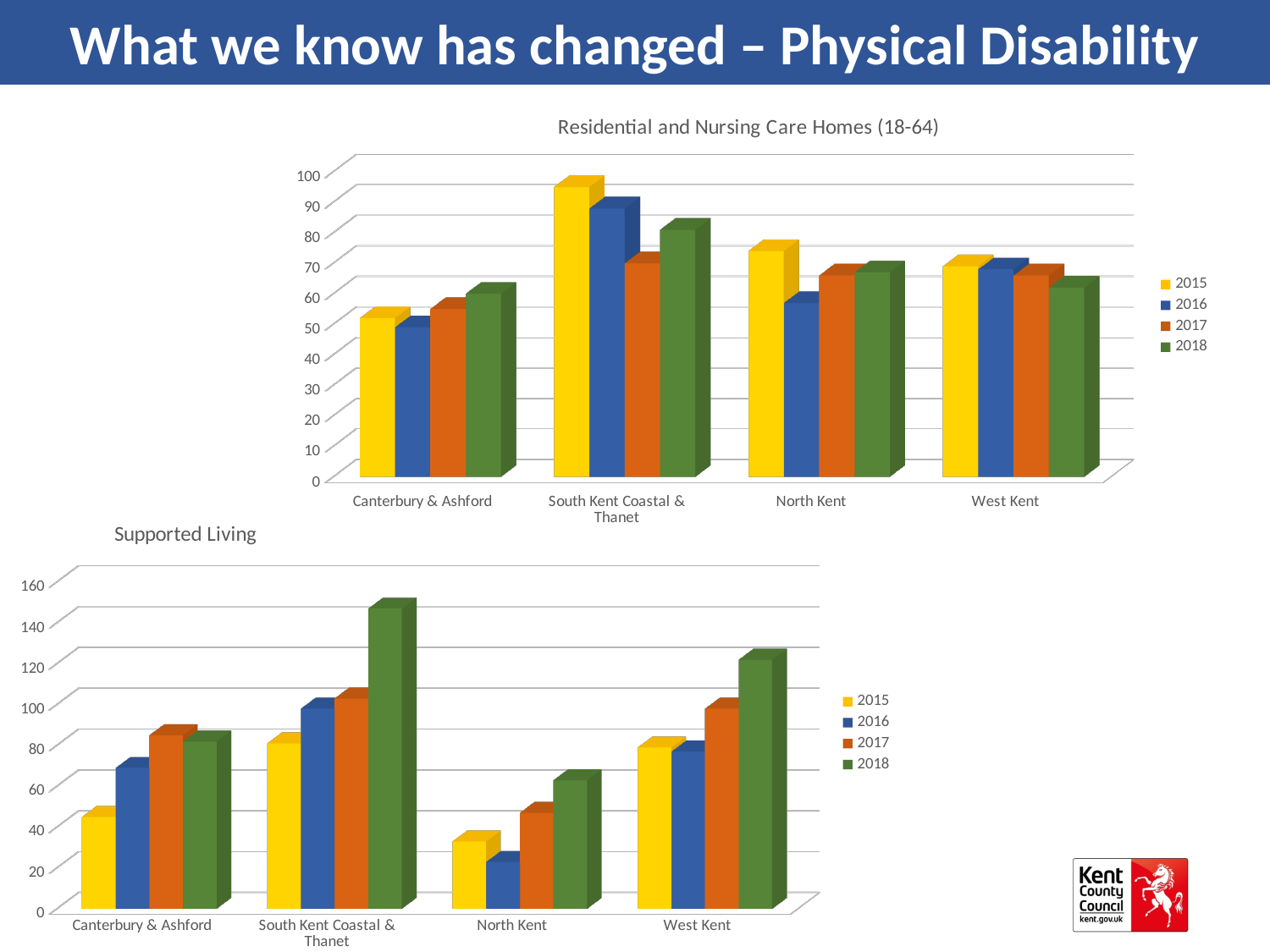
In the 'Supported Living' chart, is the 2016 value for North Kent greater or less than 40? less In the 'Supported Living' chart, is the 2018 value for South Kent Coastal & Thanet greater or less than 140? greater How many series does the legend of the 'Supported Living' chart list? 4 In the 'Supported Living' chart, do the values for South Kent Coastal & Thanet rise or fall from 2015 to 2018? Rise In the 'Supported Living' chart, which area has the lowest 2016 value? North Kent What is the title of the upper chart on the slide? Residential and Nursing Care Homes (18-64) In the 'Residential and Nursing Care Homes (18-64)' chart, which is larger for North Kent: the 2015 value or the 2016 value? 2015 What kind of chart is the 'Residential and Nursing Care Homes (18-64)' chart? Bar chart How many area categories are shown on the x axis of the 'Residential and Nursing Care Homes (18-64)' chart? 4 In the 'Supported Living' chart, which area has the highest 2018 value? South Kent Coastal & Thanet In the 'Residential and Nursing Care Homes (18-64)' chart, which area has the highest 2015 value? South Kent Coastal & Thanet In the 'Residential and Nursing Care Homes (18-64)' chart, is the 2015 value for South Kent Coastal & Thanet greater or less than 90? greater